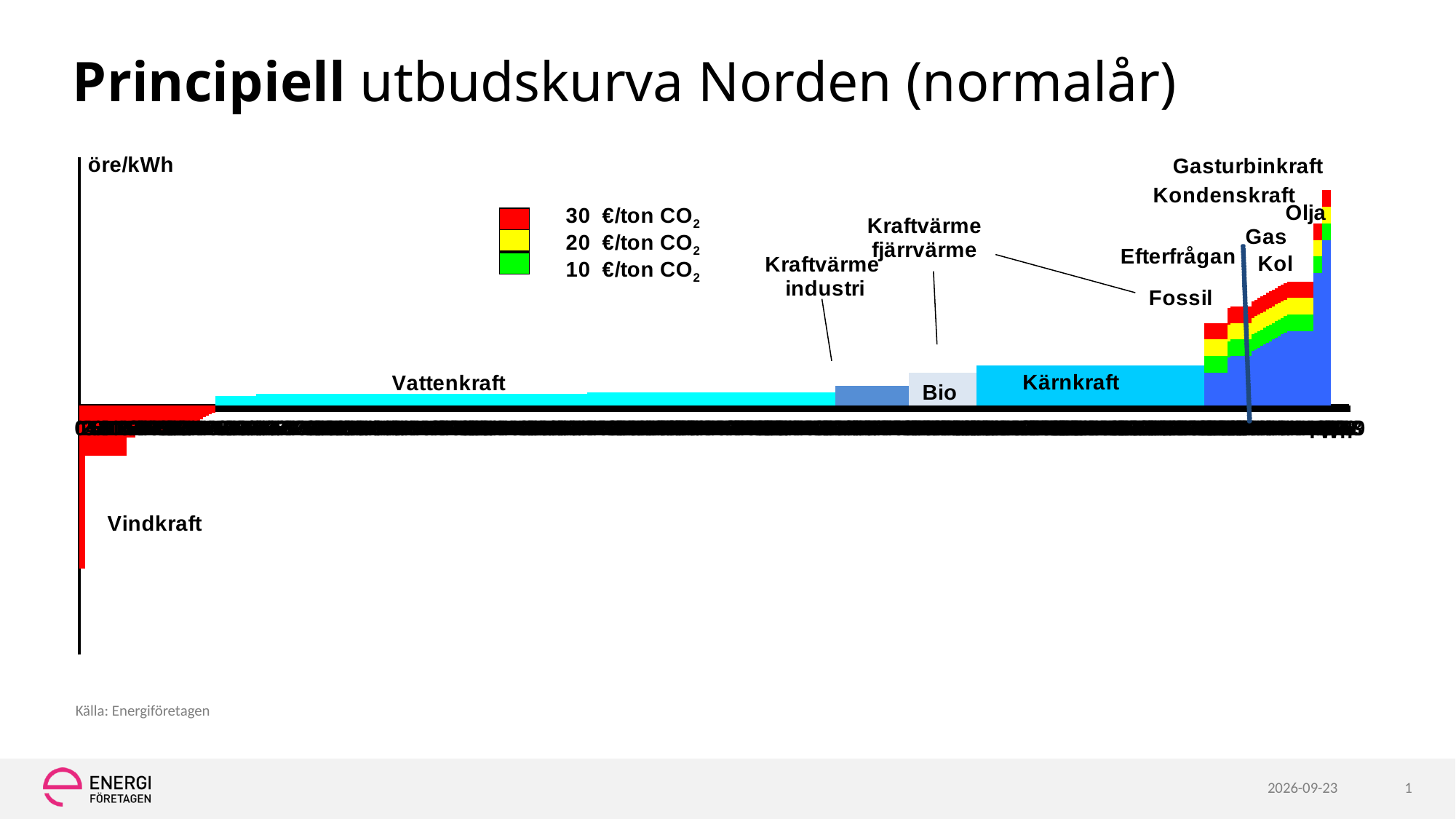
Do the values of the supply curve rise or fall from left to right? Rise Is Kärnkraft plotted higher or lower on the curve than Vattenkraft? Higher How many CO2 price levels does the legend list? 3 Is Kol plotted higher or lower on the curve than Olja? Lower Which technology is plotted below the horizontal axis, with a negative value? Vindkraft What unit is shown on the vertical axis of the chart? öre/kWh Which colour in the legend represents 30 €/ton CO2? Red Which is plotted higher on the curve, Fossil or Bio? Fossil Which technology is at the highest point of the supply curve? Gasturbinkraft